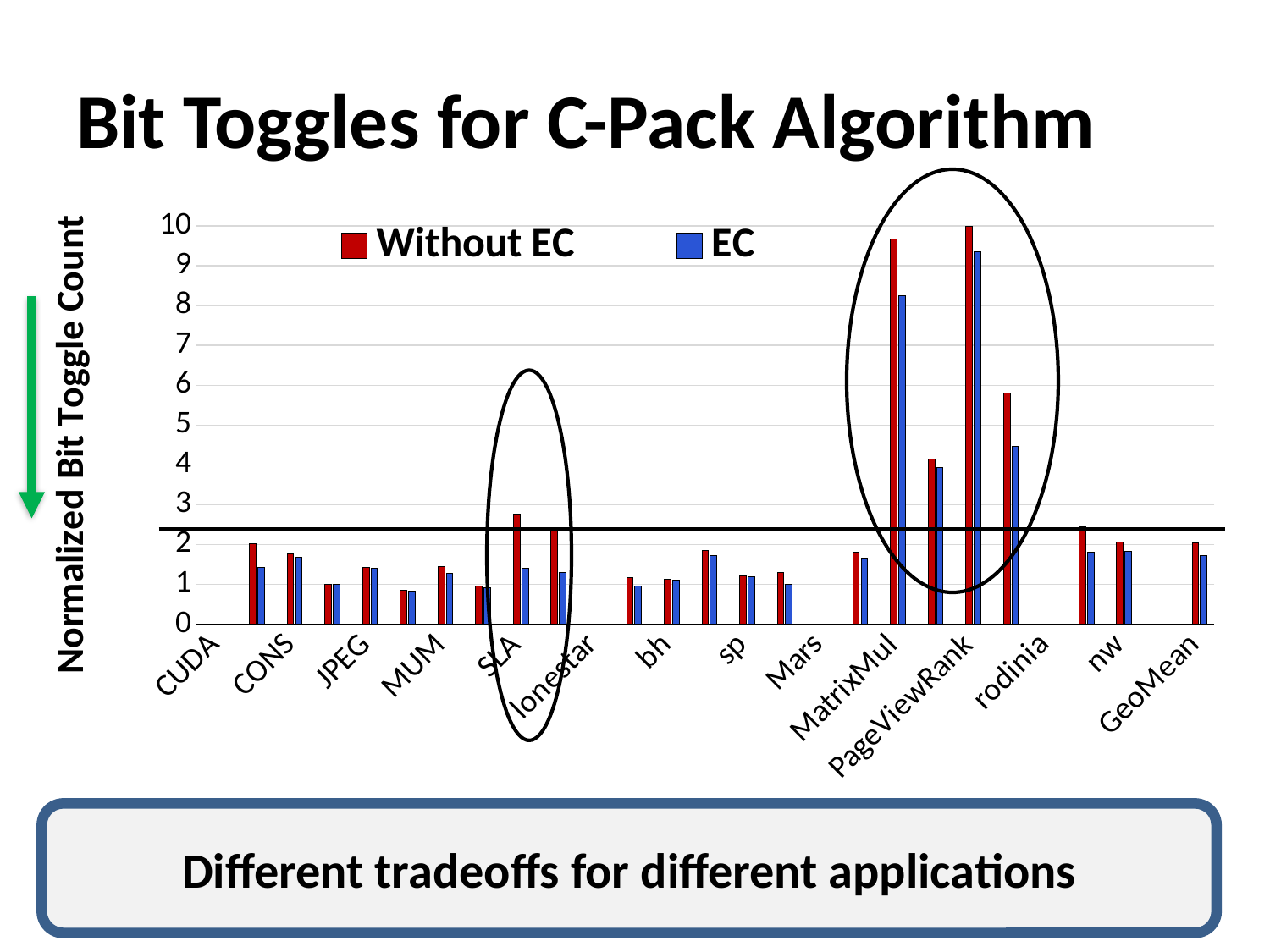
What kind of chart is shown on the slide? bar chart How many category labels are shown along the x axis? 14 Which colour represents the EC series? blue Is the Without EC value for GeoMean greater or less than 3? less What are the two series named in the legend? Without EC and EC For GeoMean, which is larger: the Without EC bar or the EC bar? Without EC Is the EC value for GeoMean greater or less than 1? greater What is the label of the y axis? Normalized Bit Toggle Count How many series does the legend list? 2 What is the highest value shown on the y axis? 10 Which series contains the tallest bar in the chart? Without EC Is the Without EC value for nw greater or less than 3? less